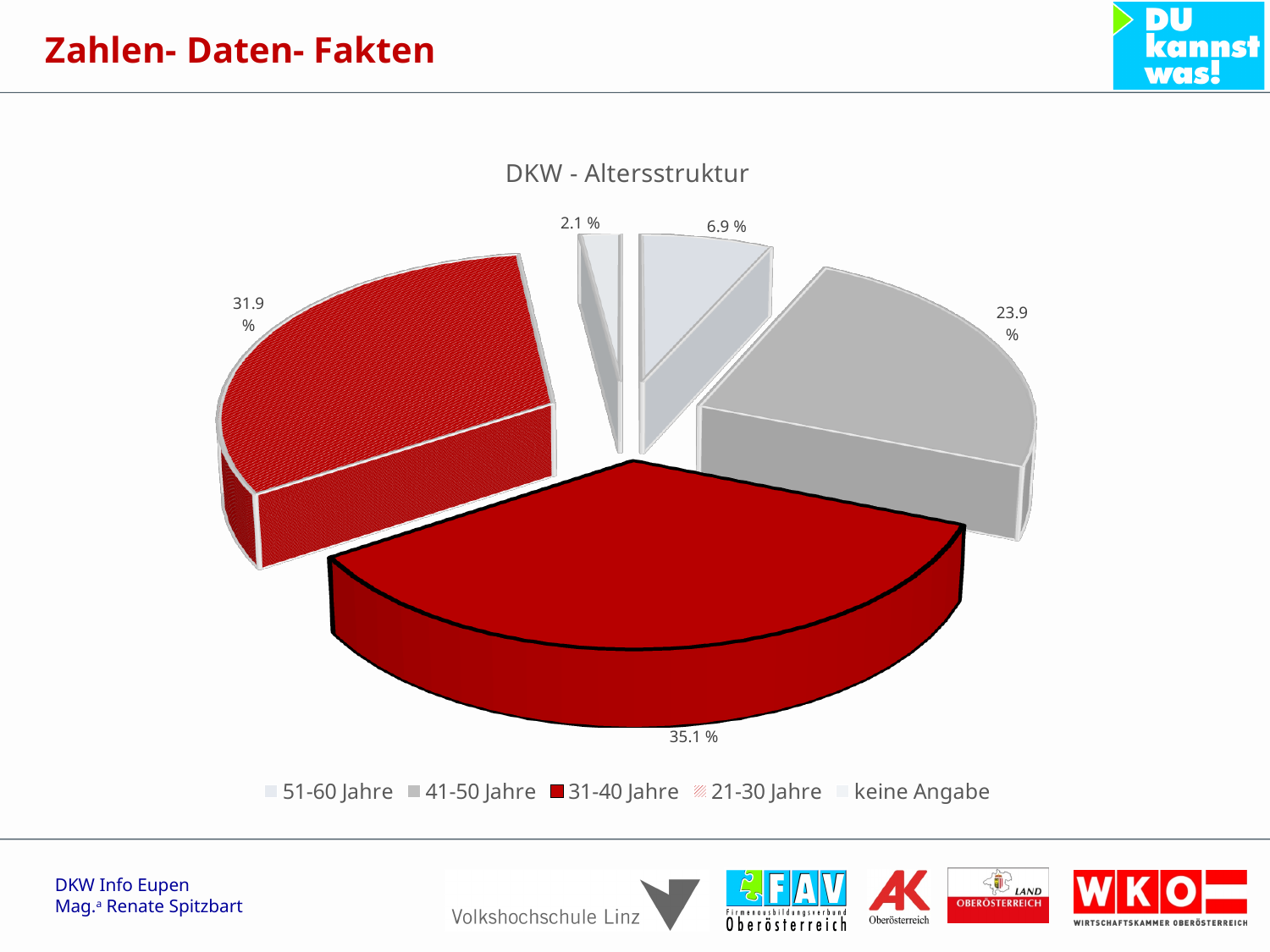
What percentage is shown for the 51-60 Jahre slice? 6.9 % Which age group has the largest share of the pie? 31-40 Jahre What percentage is shown for the 41-50 Jahre slice? 23.9 % What percentage is shown for the 21-30 Jahre slice? 31.9 % What is the difference in percentage points between the 31-40 Jahre slice and the 41-50 Jahre slice? 11.2 What type of chart is shown on the slide? pie chart Which legend category has the smallest share of the pie? keine Angabe What is the title of the chart? DKW - Altersstruktur How many slices does the pie chart have? 5 How many entries does the legend list? 5 What percentage is shown for the 31-40 Jahre slice? 35.1 % What percentage is shown for the keine Angabe slice? 2.1 %